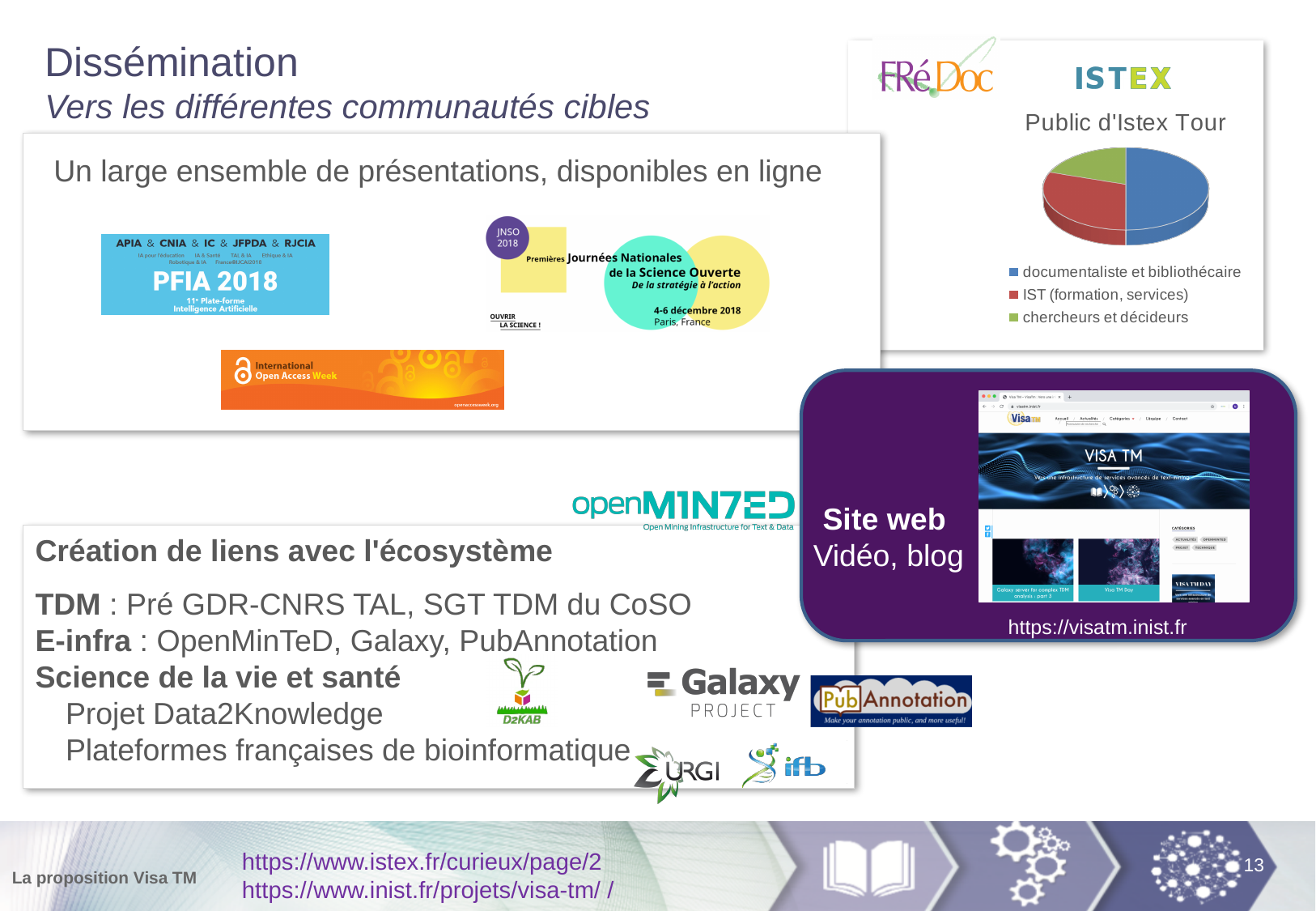
In the "Public d'Istex Tour" pie chart, which slice is larger: "documentaliste et bibliothécaire" or "IST (formation, services)"? documentaliste et bibliothécaire What is the title of the pie chart on the slide? Public d'Istex Tour In the "Public d'Istex Tour" pie chart, which slice is larger: "IST (formation, services)" or "chercheurs et décideurs"? IST (formation, services) Which category has the largest slice in the "Public d'Istex Tour" pie chart? documentaliste et bibliothécaire What kind of chart is shown under the title "Public d'Istex Tour"? pie chart What colour represents "chercheurs et décideurs" in the "Public d'Istex Tour" pie chart? green Which category has the smallest slice in the "Public d'Istex Tour" pie chart? chercheurs et décideurs How many entries does the legend of the "Public d'Istex Tour" pie chart list? 3 How many slices does the "Public d'Istex Tour" pie chart have? 3